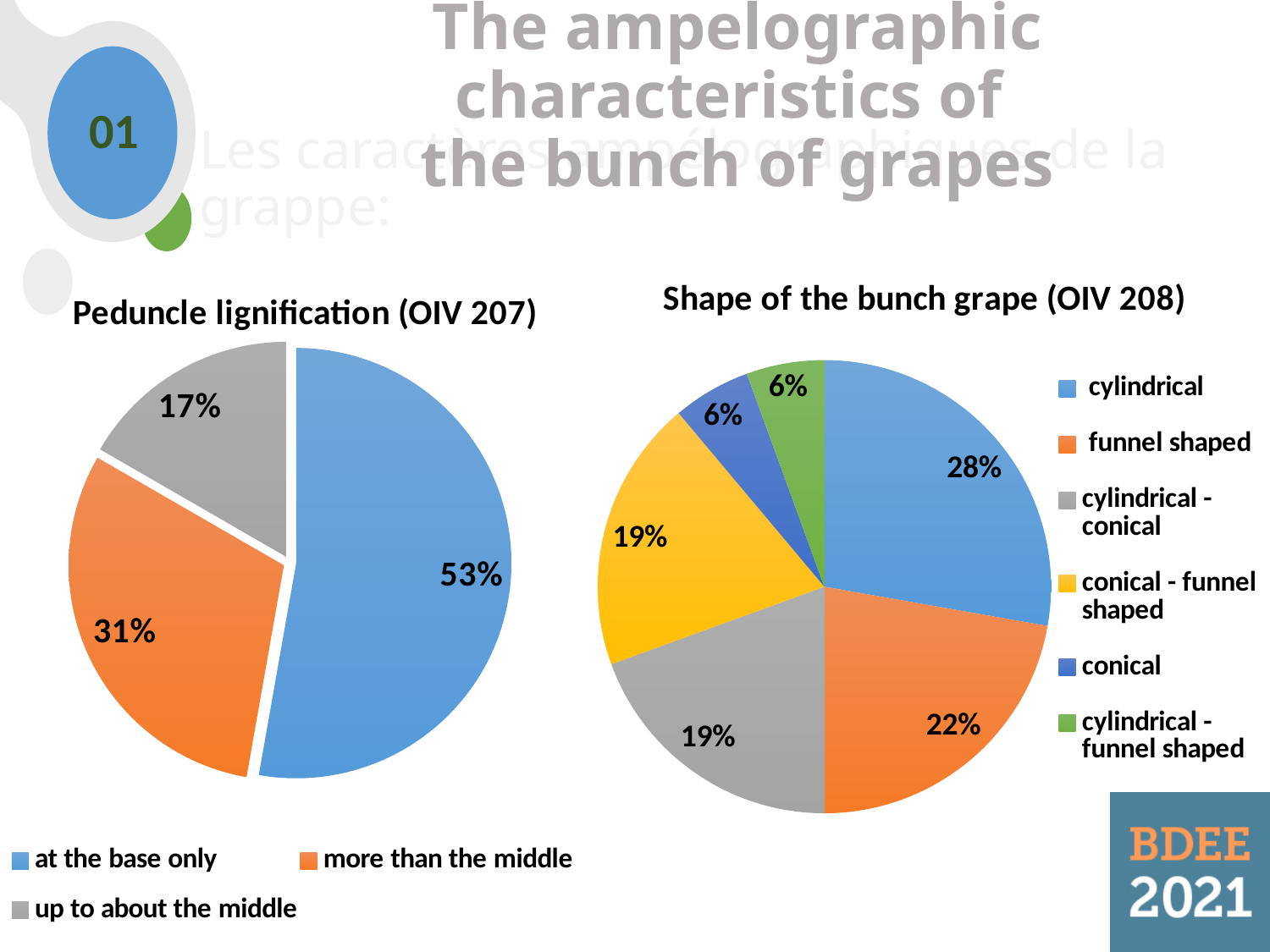
How many categories does the legend of the 'Shape of the bunch grape (OIV 208)' chart list? 6 In the 'Shape of the bunch grape (OIV 208)' chart, what share is 'conical'? 6% In the 'Shape of the bunch grape (OIV 208)' chart, which category has the largest slice? cylindrical In the 'Peduncle lignification (OIV 207)' chart, which category has the smallest slice? up to about the middle In the 'Shape of the bunch grape (OIV 208)' chart, what share is 'cylindrical'? 28% In the 'Peduncle lignification (OIV 207)' chart, what is the difference between 'at the base only' and 'more than the middle'? 22% In the 'Shape of the bunch grape (OIV 208)' chart, which is larger, 'cylindrical' or 'funnel shaped'? cylindrical What type of chart is the 'Shape of the bunch grape (OIV 208)' chart? pie chart How many categories does the 'Peduncle lignification (OIV 207)' chart show? 3 In the 'Peduncle lignification (OIV 207)' chart, what share is 'at the base only'? 53% In the 'Shape of the bunch grape (OIV 208)' chart, what share is 'funnel shaped'? 22% In the 'Peduncle lignification (OIV 207)' chart, what share is 'more than the middle'? 31%